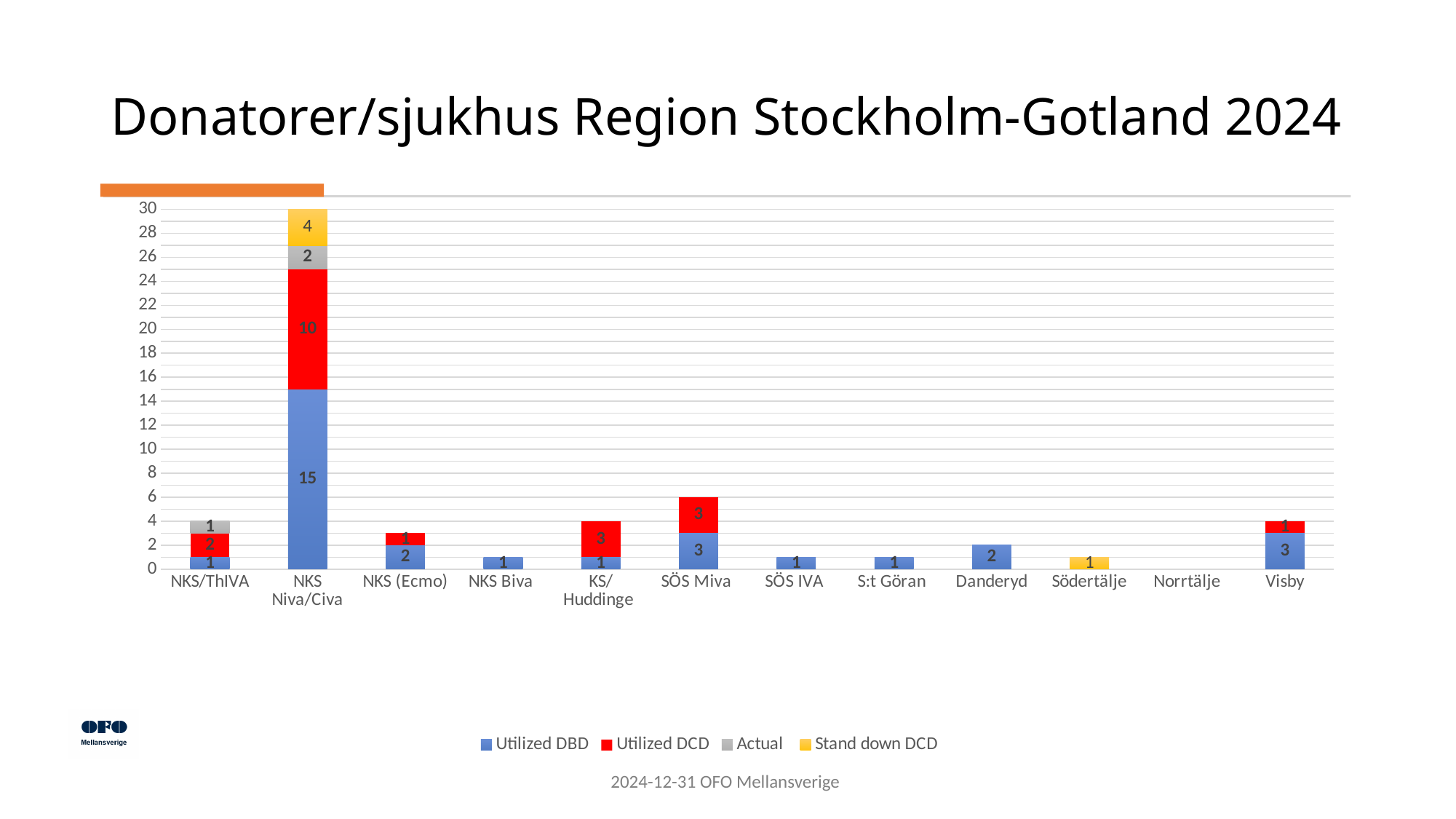
What is the Utilized DCD value for NKS Niva/Civa? 10 What is the Utilized DCD value for KS/Huddinge? 3 What type of chart is shown on the slide? Stacked bar chart How many series does the legend list? 4 Which is larger, the Utilized DBD value for Danderyd or the Utilized DBD value for Visby? Visby What is the total of the stacked bar for SÖS Miva? 6 What is the Utilized DBD value for NKS Niva/Civa? 15 How many hospital categories are shown on the x axis? 12 What is the difference between the Utilized DBD values for NKS Niva/Civa and SÖS Miva? 12 What is the total of the stacked bar for Visby? 4 Which hospital has the highest total stacked bar? NKS Niva/Civa What is the Stand down DCD value for Södertälje? 1